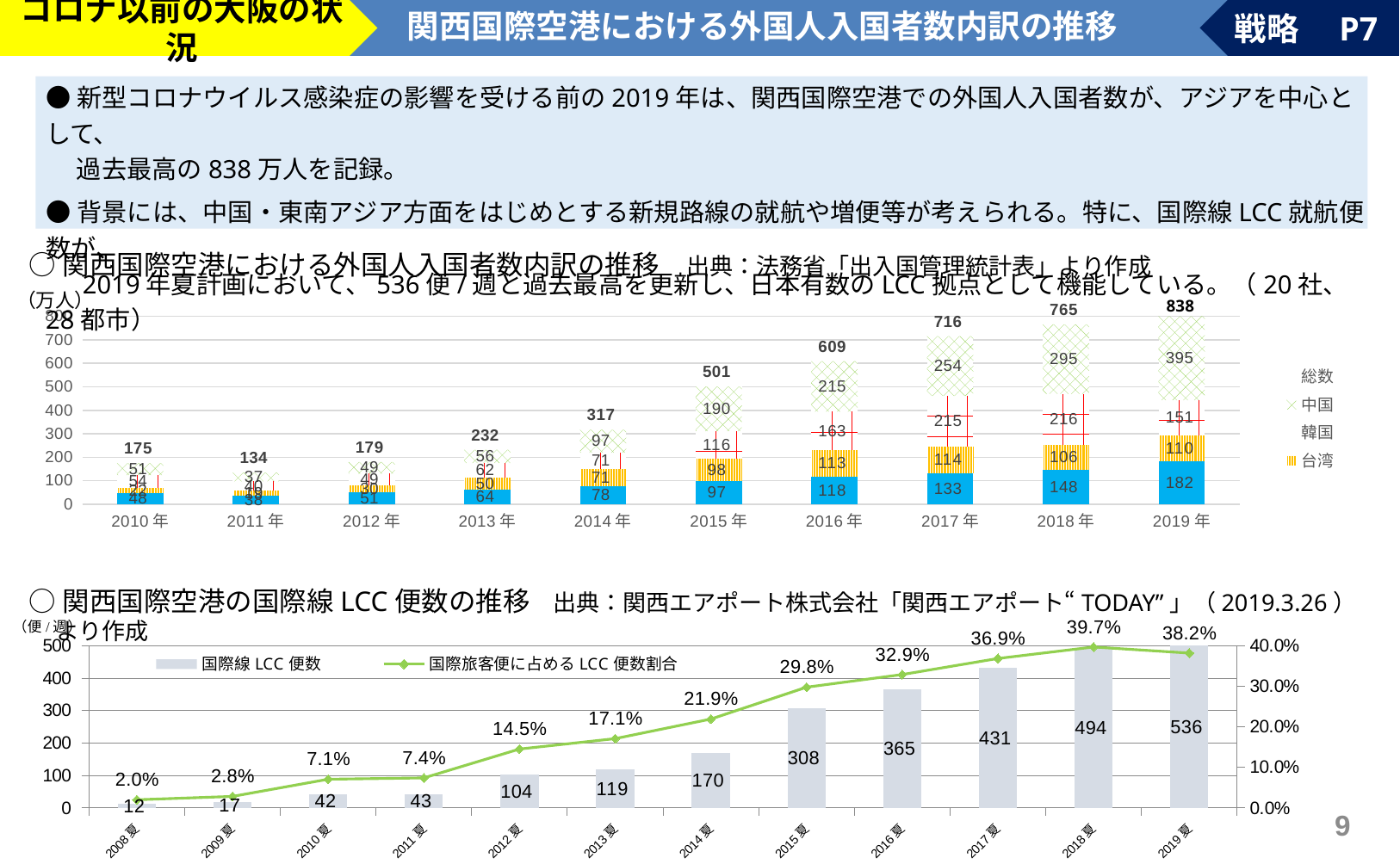
In the bottom chart (関西国際空港の国際線LCC便数の推移), what is the number of 国際線LCC便数 for 2019夏? 536 In the bottom chart (関西国際空港の国際線LCC便数の推移), which period has the highest 国際旅客便に占めるLCC便数割合? 2018夏 In the top chart (関西国際空港における外国人入国者数内訳の推移), which year has the lowest total (総数)? 2011年 In the top chart (関西国際空港における外国人入国者数内訳の推移), which is larger, the 中国 value for 2016年 or for 2017年? 2017年 In the top chart (関西国際空港における外国人入国者数内訳の推移), what is the total (総数) for 2019年? 838 In the bottom chart (関西国際空港の国際線LCC便数の推移), how many series does the legend list? 2 In the bottom chart (関西国際空港の国際線LCC便数の推移), do the 国際線LCC便数 values rise or fall from 2008夏 to 2019夏? rise In the top chart (関西国際空港における外国人入国者数内訳の推移), what is the difference between the totals for 2019年 and 2018年? 73 In the bottom chart (関西国際空港の国際線LCC便数の推移), what is the difference in 国際線LCC便数 between 2019夏 and 2018夏? 42 In the top chart (関西国際空港における外国人入国者数内訳の推移), how many years are shown on the x axis? 10 In the top chart (関西国際空港における外国人入国者数内訳の推移), what is the value for 中国 in 2019年? 395 In the bottom chart (関西国際空港の国際線LCC便数の推移), what is the 国際旅客便に占めるLCC便数割合 for 2018夏? 39.7%